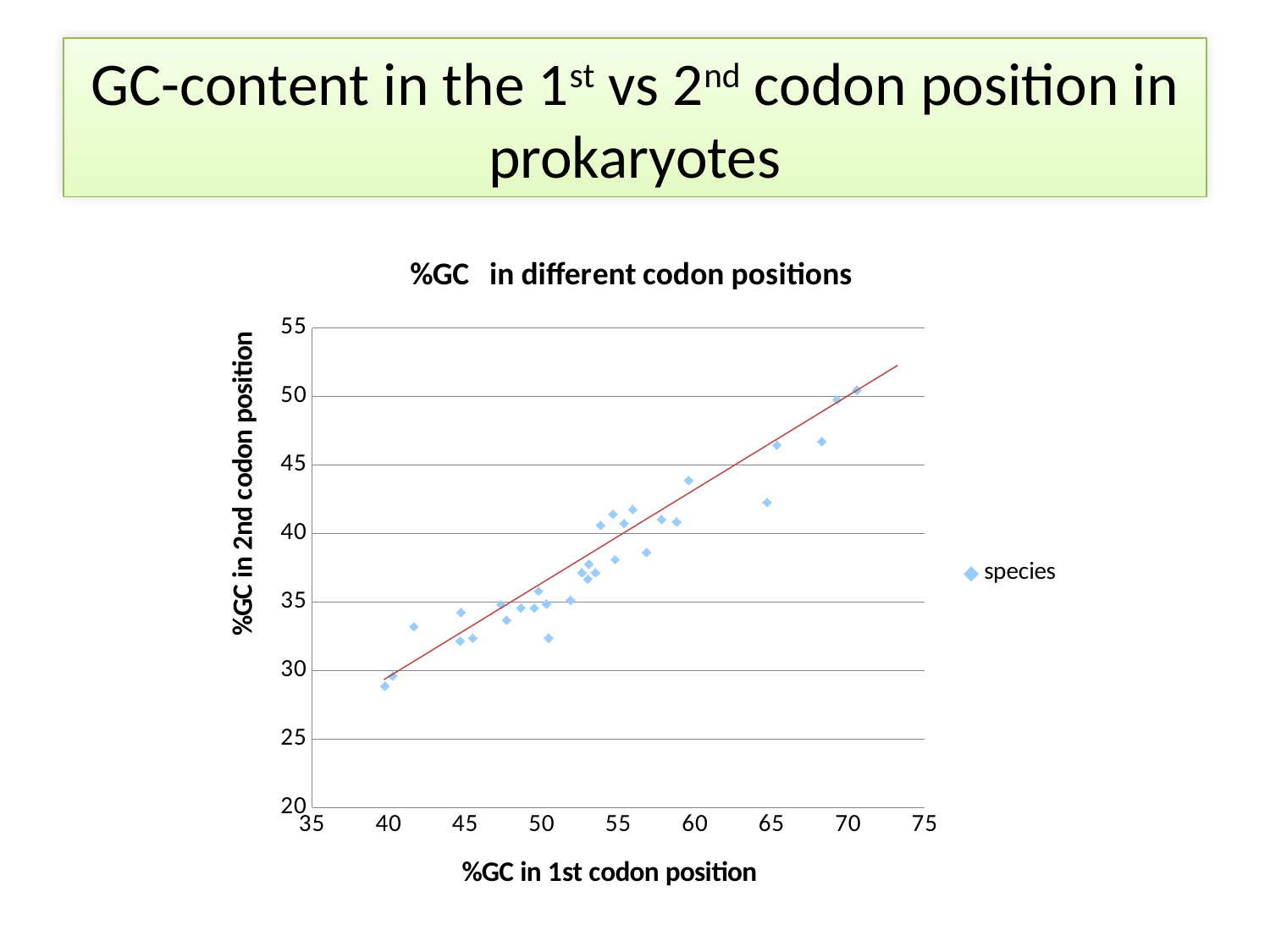
What is the highest value shown on the y axis of the chart? 55 Is the %GC in 2nd codon position of the rightmost point greater or less than 45? greater Is the %GC in 2nd codon position of the leftmost point greater or less than 30? less Is the %GC in 1st codon position of the rightmost point greater or less than 65? greater What is the highest value shown on the x axis of the chart? 75 What is the name of the series shown in the legend? species As %GC in the 1st codon position increases, do the values of %GC in the 2nd codon position generally rise or fall? Rise How many series does the legend list? 1 What kind of chart is shown on the slide? Scatter plot What is the title of the chart? %GC in different codon positions What is the lowest value shown on the x axis of the chart? 35